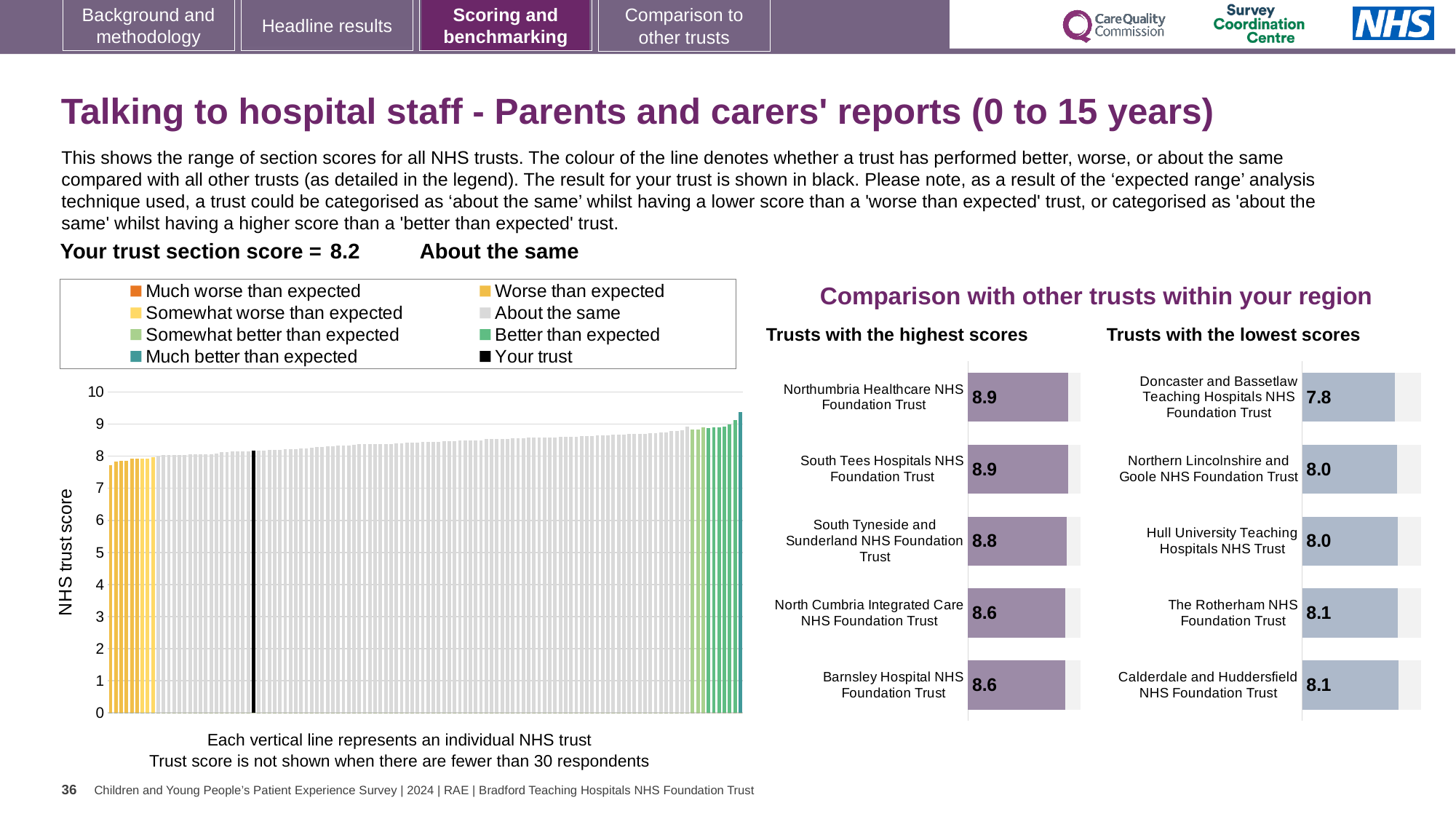
In the 'Trusts with the lowest scores' chart, which trust has the lowest score? Doncaster and Bassetlaw Teaching Hospitals NHS Foundation Trust In the large chart on the left, do the trust scores rise or fall from left to right? Rise In the 'Trusts with the highest scores' chart, what is the score for South Tyneside and Sunderland NHS Foundation Trust? 8.8 How many trusts are listed in the 'Trusts with the highest scores' chart? 5 In the 'Trusts with the highest scores' chart, which has the higher score: South Tyneside and Sunderland NHS Foundation Trust or North Cumbria Integrated Care NHS Foundation Trust? South Tyneside and Sunderland NHS Foundation Trust How many entries does the legend of the large chart on the left list? 8 What kind of chart is the large chart on the left showing NHS trust scores? Bar chart In the 'Trusts with the highest scores' chart, what is the score for Northumbria Healthcare NHS Foundation Trust? 8.9 In the 'Trusts with the lowest scores' chart, what is the difference between the scores of Calderdale and Huddersfield NHS Foundation Trust and Doncaster and Bassetlaw Teaching Hospitals NHS Foundation Trust? 0.3 In the large chart on the left, is the value for 'Your trust' greater or less than 5? greater In the 'Trusts with the lowest scores' chart, what is the score for Doncaster and Bassetlaw Teaching Hospitals NHS Foundation Trust? 7.8 In the 'Trusts with the highest scores' chart, what is the difference between the scores of Northumbria Healthcare NHS Foundation Trust and Barnsley Hospital NHS Foundation Trust? 0.3